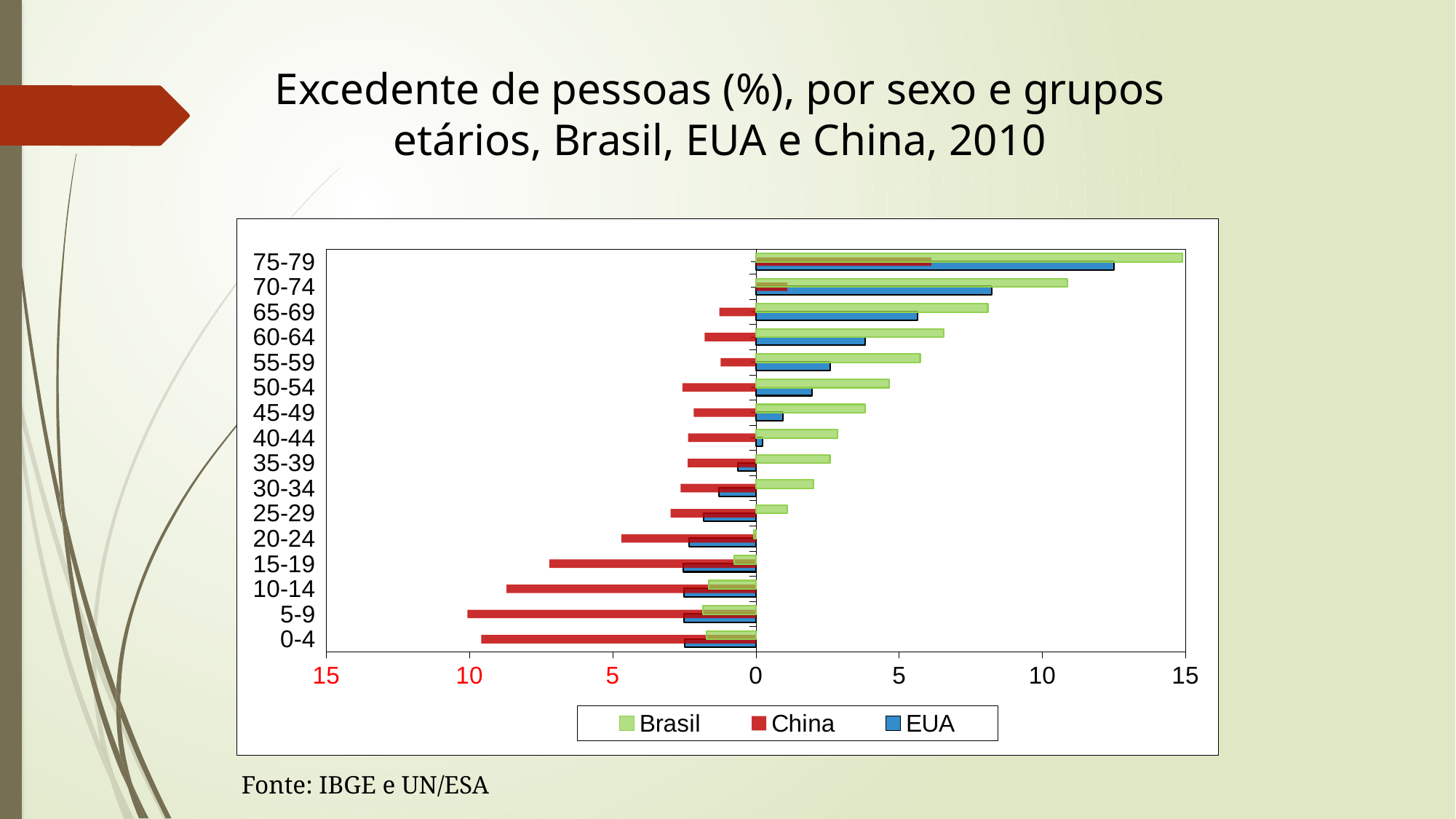
In the 50-54 age group, which is larger, the value for Brasil or the value for EUA? Brasil Which series is shown in red in the legend? China Which age group has the highest value for EUA? 75-79 Is the value for EUA in the 60-64 age group greater or less than 5? less Which age group has the highest value for Brasil? 75-79 Is the value for Brasil in the 75-79 age group greater or less than 10? greater What kind of chart is shown on the slide? Bar chart How many series does the legend list? 3 Do the Brasil values rise or fall as the age groups get older? rise Is the value for Brasil in the 65-69 age group greater or less than 10? less Which age group has the longest China bar on the left (negative) side of the axis? 5-9 How many age groups are shown on the vertical axis? 16